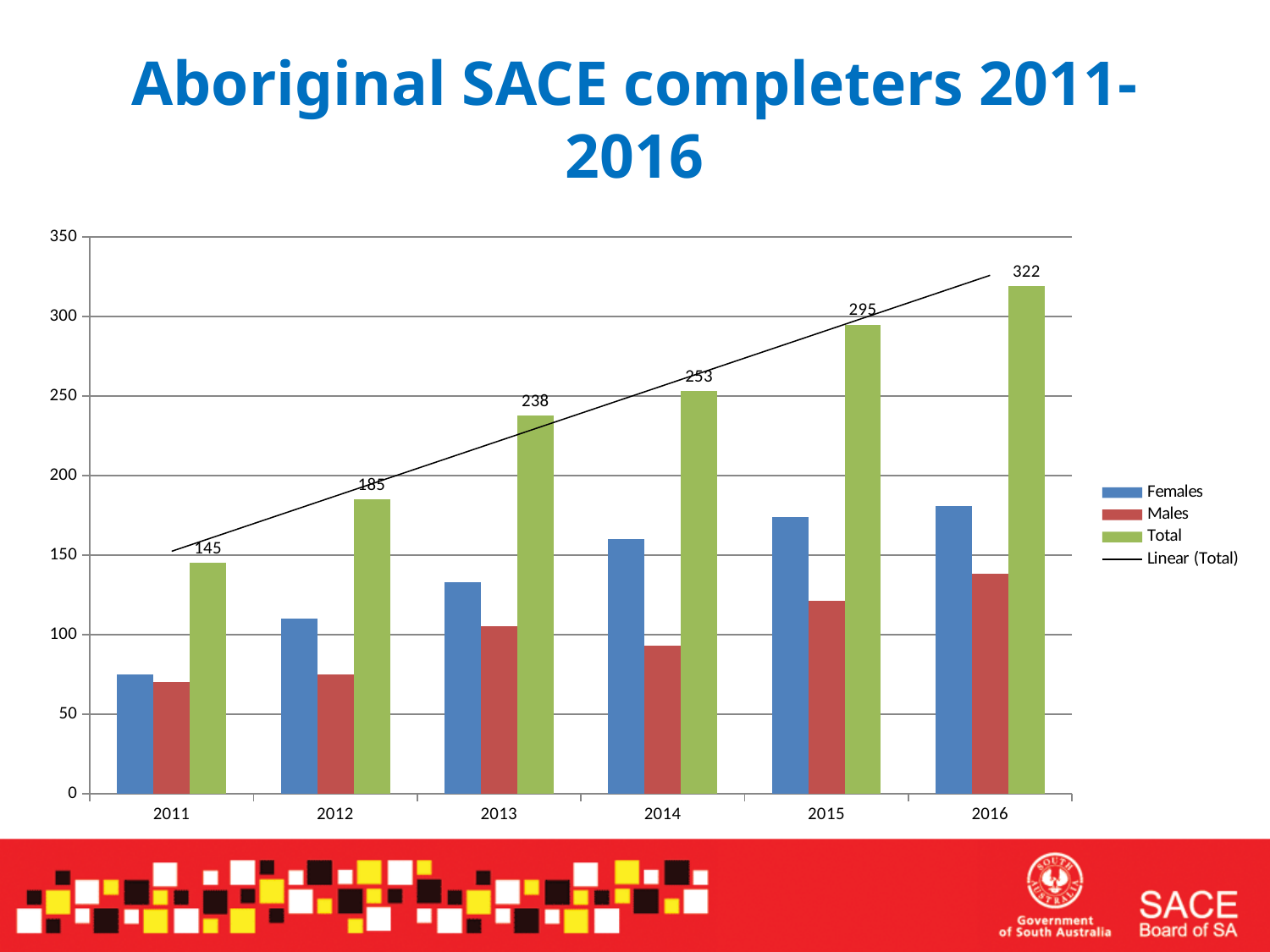
Which year has the lowest Total? 2011 Is the value for Females in 2011 greater or less than 100? less What is the Total value for 2013? 238 Is the value for Males in 2016 greater or less than 100? greater Which is larger, the Total for 2014 or the Total for 2015? 2015 What is the Total value for 2016? 322 How many years are shown on the x axis? 6 What is the difference between the Total for 2016 and the Total for 2011? 177 Does the Total rise or fall from 2011 to 2016? rise How many entries does the legend list? 4 What is the Total value for 2011? 145 Which year has the highest Total? 2016